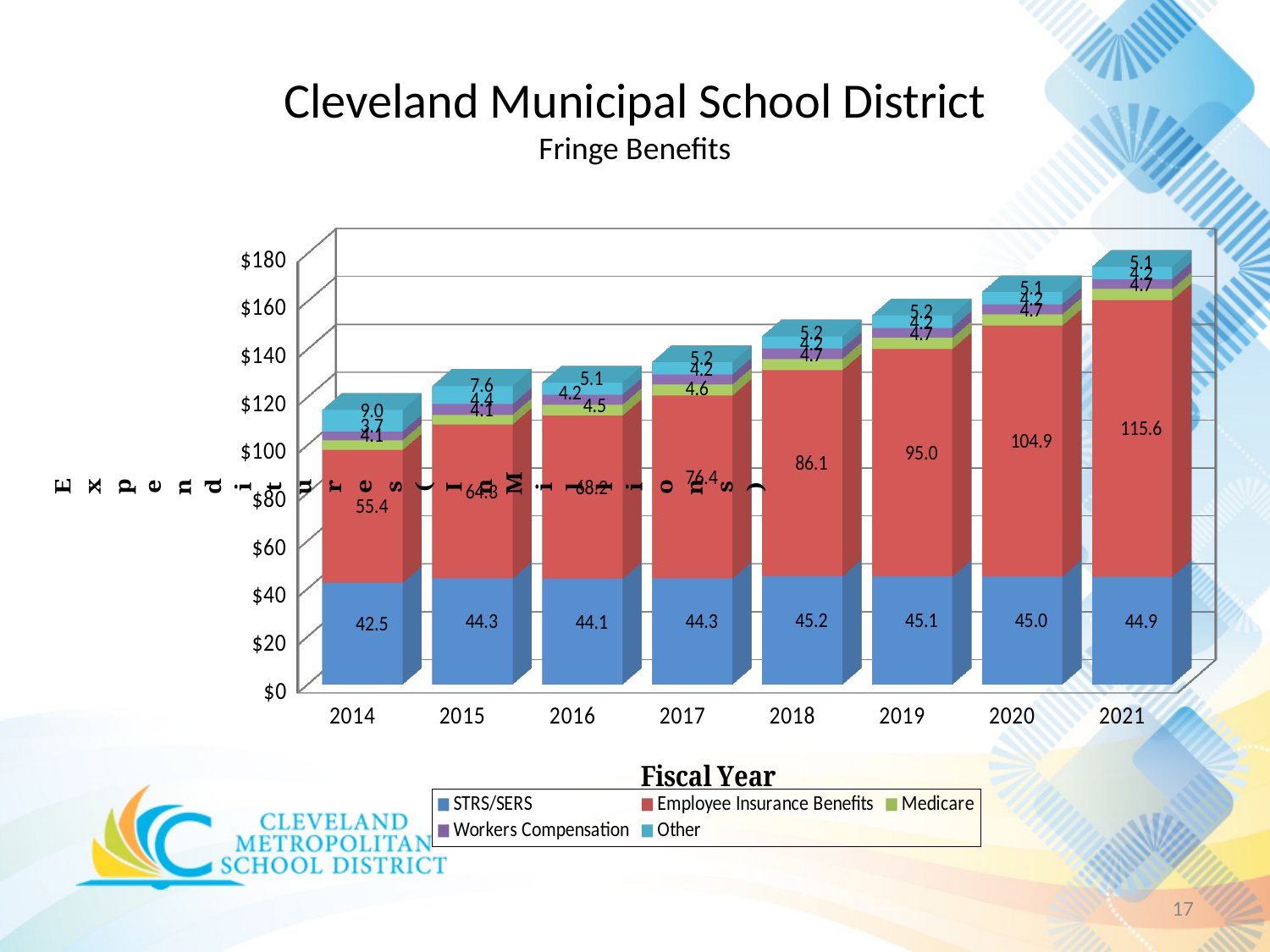
In which fiscal year is the STRS/SERS value lowest? 2014 What is the difference between the Employee Insurance Benefits values for 2021 and 2020? 10.7 Does the Employee Insurance Benefits value rise or fall from 2014 to 2021? rise What is the Employee Insurance Benefits value for fiscal year 2018? 86.1 Which is larger, the Other value for 2014 or the Other value for 2021? 2014 How many fiscal years are shown on the x axis? 8 What is the Other value for fiscal year 2014? 9.0 How many series does the legend list? 5 What is the STRS/SERS value for fiscal year 2014? 42.5 What is the Employee Insurance Benefits value for fiscal year 2021? 115.6 In which fiscal year is the Employee Insurance Benefits value highest? 2021 Is the total height of the 2021 bar greater or less than $160? greater